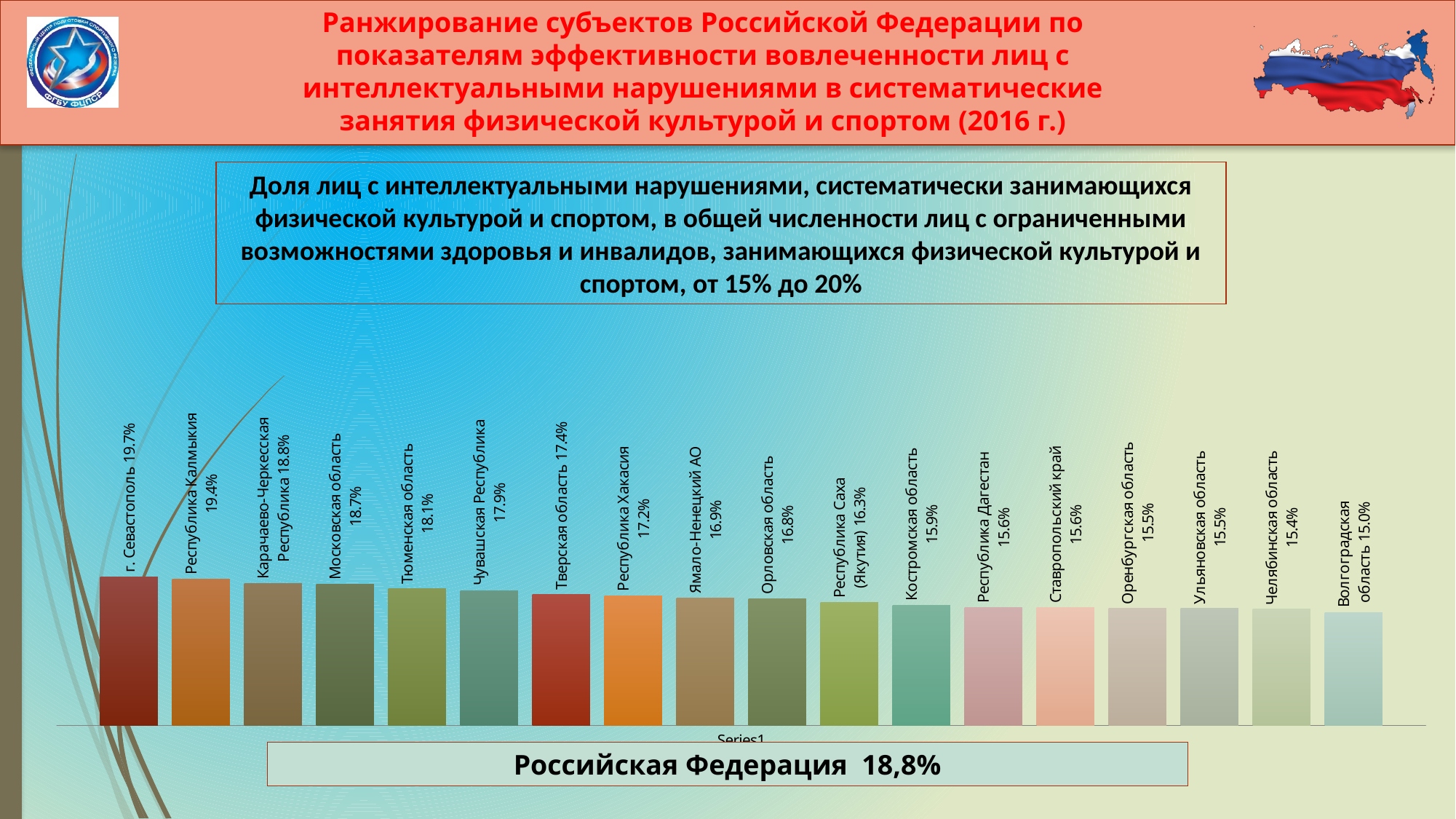
What is the difference between the values for Республика Калмыкия and Тюменская область? 1.3% Which region has the lowest value on the chart? Волгоградская область What value is given for Российская Федерация in the box below the chart? 18,8% What is the difference between the values for г. Севастополь and Волгоградская область? 4.7% Which region has the highest value on the chart? г. Севастополь Do the values rise or fall from left to right along the x axis? fall What is the value for г. Севастополь? 19.7% What is the value for Московская область? 18.7% What is the value for Республика Саха (Якутия)? 16.3% Which is larger, the value for Чувашская Республика or the value for Орловская область? Чувашская Республика How many regions are shown on the chart? 18 What kind of chart is shown on the slide? bar chart